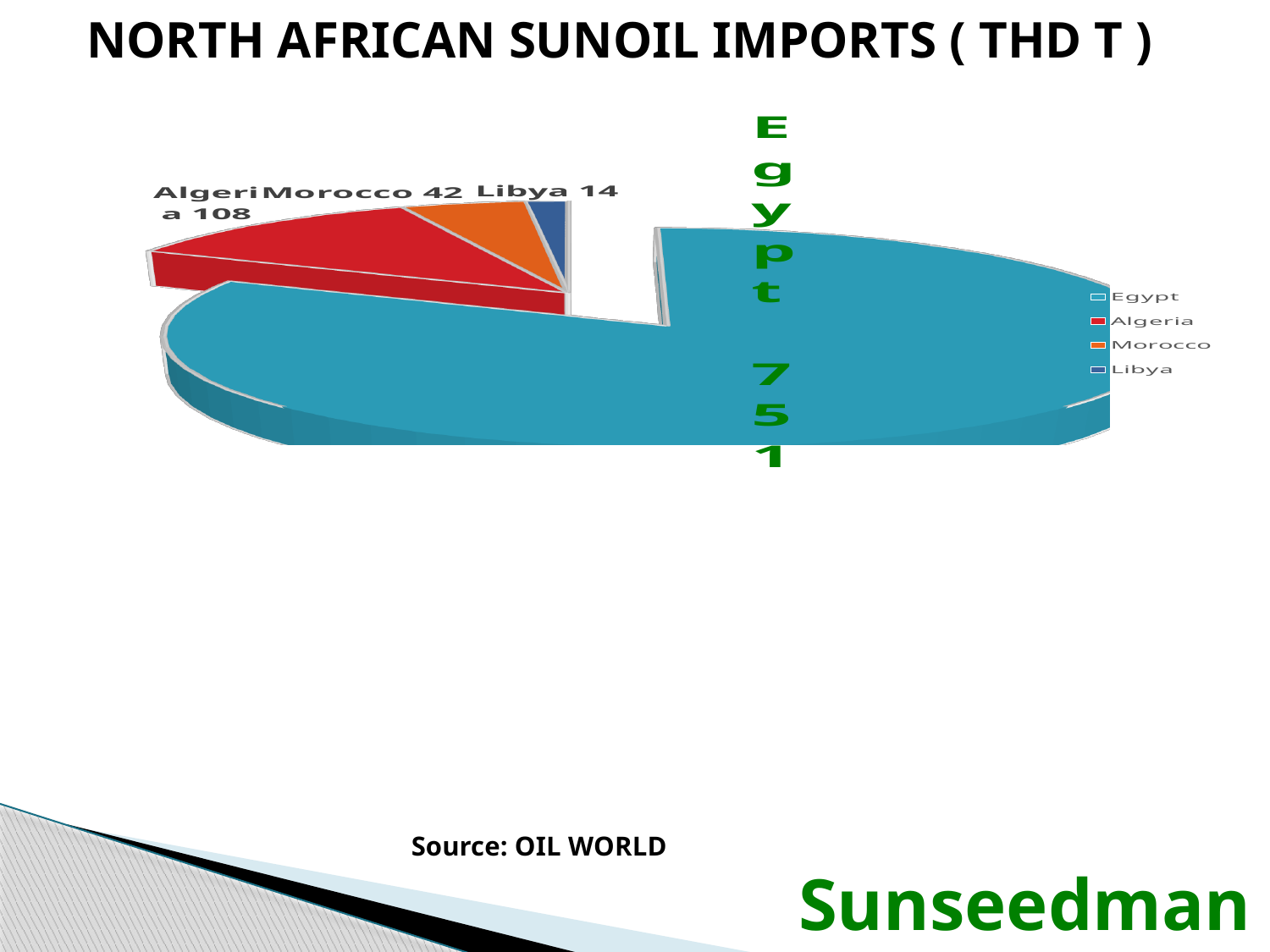
What is the value for Algeria in the North African sunoil imports chart? 108 Which is larger, the value for Algeria or the value for Morocco? Algeria What is the difference between Morocco's and Libya's sunoil imports? 28 What type of chart is shown on the slide? Pie chart How many countries are shown in the pie chart? 4 What is the value for Egypt in the North African sunoil imports chart? 751 What is the difference between Egypt's and Algeria's sunoil imports? 643 What is the title of the chart? NORTH AFRICAN SUNOIL IMPORTS ( THD T ) What is the value for Libya in the North African sunoil imports chart? 14 Which country has the largest share of North African sunoil imports? Egypt Which country has the smallest share of North African sunoil imports? Libya What is the value for Morocco in the North African sunoil imports chart? 42